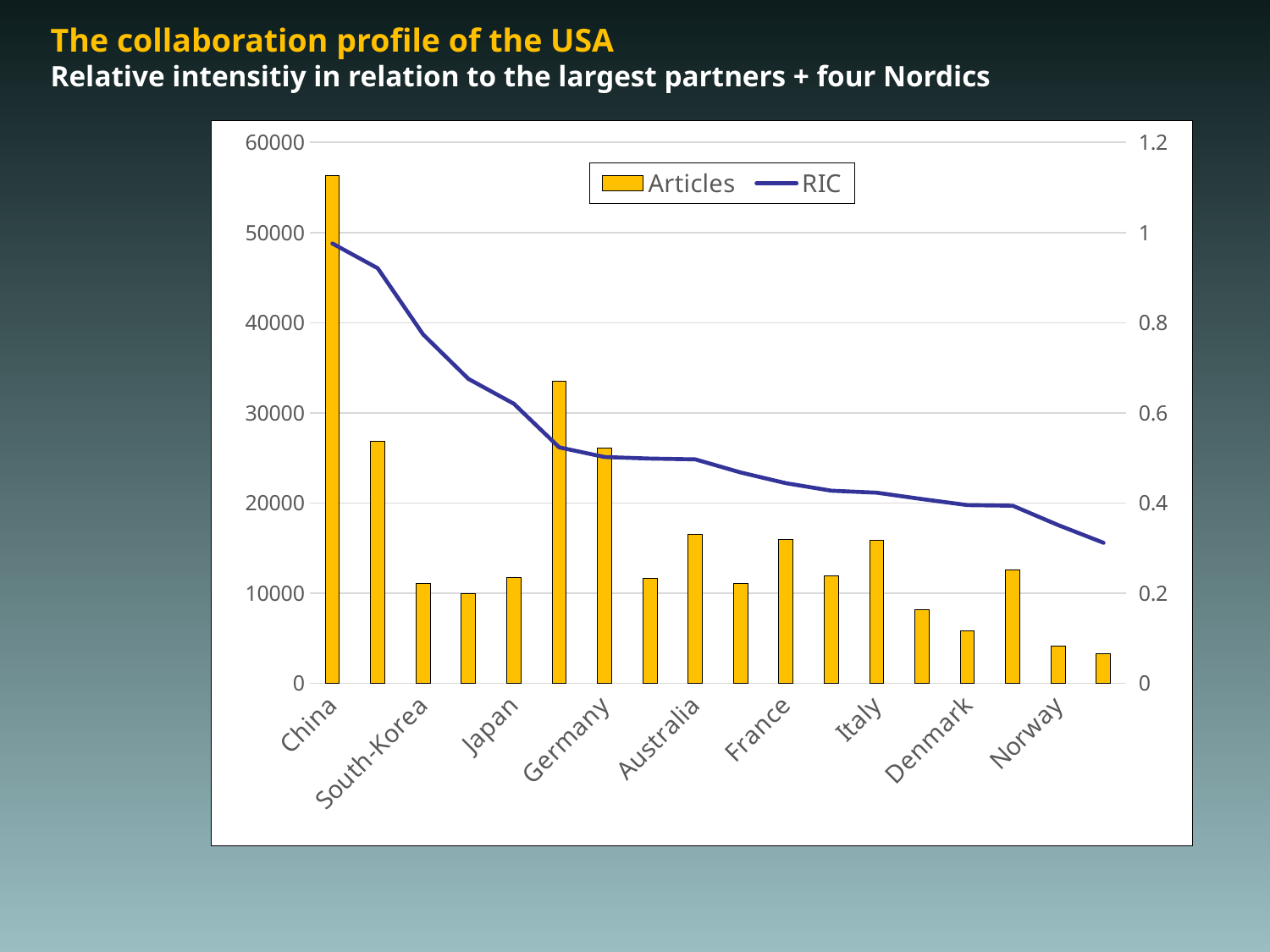
Is the RIC value for China greater or less than 0.8? greater Which has more Articles, Denmark or Norway? Denmark Which has more Articles, Germany or South-Korea? Germany Which country has the highest number of Articles? China Is the Articles value for China greater or less than 50000? greater Is the Articles value for Germany greater or less than 30000? less Does the RIC line generally rise or fall from China to Norway? fall What kind of chart is shown on the slide? Combined bar and line chart How many series does the legend list? 2